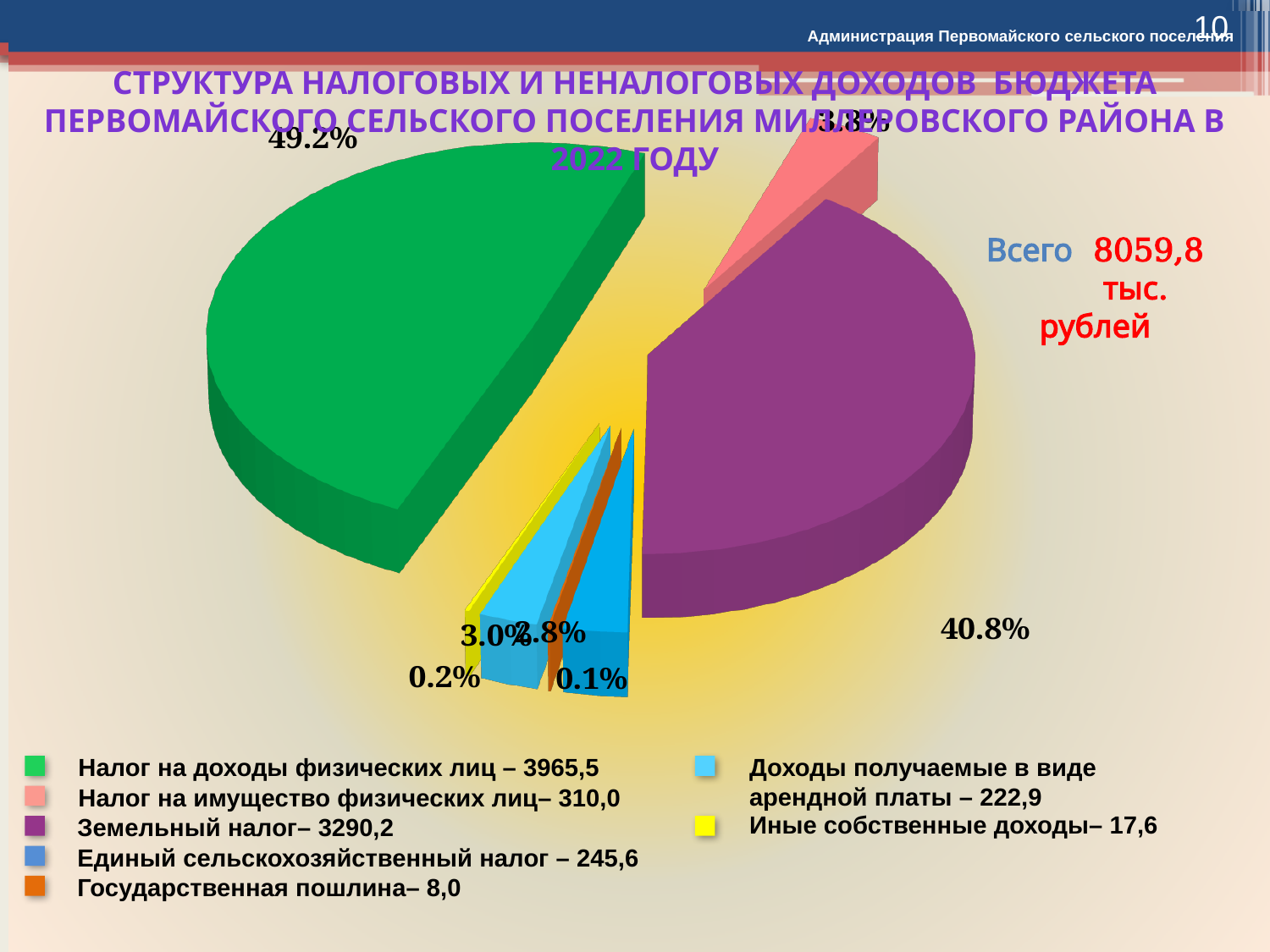
Which is larger: Земельный налог or Налог на имущество физических лиц? Земельный налог What total amount (Всего) is stated next to the pie chart? 8059,8 тыс. рублей Which category has the smallest share of the pie? Государственная пошлина What share of the pie does the pink slice (Налог на имущество физических лиц) represent? 3.8% Which category has the largest share of the pie? Налог на доходы физических лиц According to the legend, what is the value for Доходы получаемые в виде арендной платы? 222,9 What kind of chart is shown on the slide? pie chart What share of the pie does the purple slice (Земельный налог) represent? 40.8% What is the difference between the legend values for Налог на доходы физических лиц (3965,5) and Земельный налог (3290,2)? 675,3 According to the legend, what is the value for Земельный налог? 3290,2 What share of the pie does the green slice (Налог на доходы физических лиц) represent? 49.2% How many categories does the legend of the pie chart list? 7